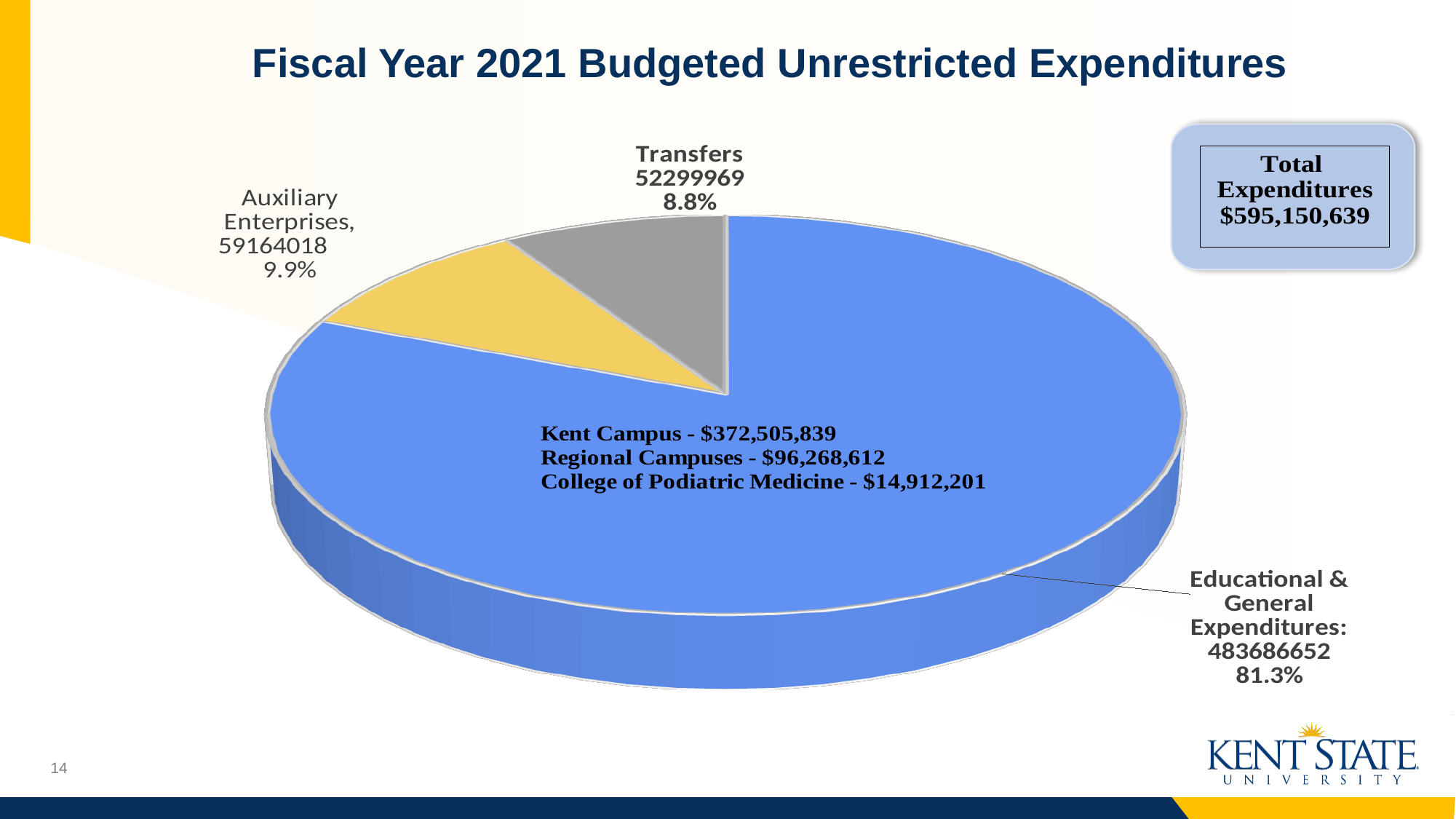
Which is larger, Auxiliary Enterprises or Transfers? Auxiliary Enterprises Which category has the largest slice of the pie? Educational & General Expenditures What is the value for Auxiliary Enterprises? 59164018 What is the value for Transfers? 52299969 What is the difference between the Auxiliary Enterprises value and the Transfers value? 6864049 How many slices does the pie chart have? 3 What share of the pie does Transfers represent? 8.8% Which category has the smallest slice of the pie? Transfers What share of the pie does Educational & General Expenditures represent? 81.3% What is the value for Educational & General Expenditures? 483686652 What kind of chart is shown on the slide? pie chart What is the title of the slide's chart? Fiscal Year 2021 Budgeted Unrestricted Expenditures